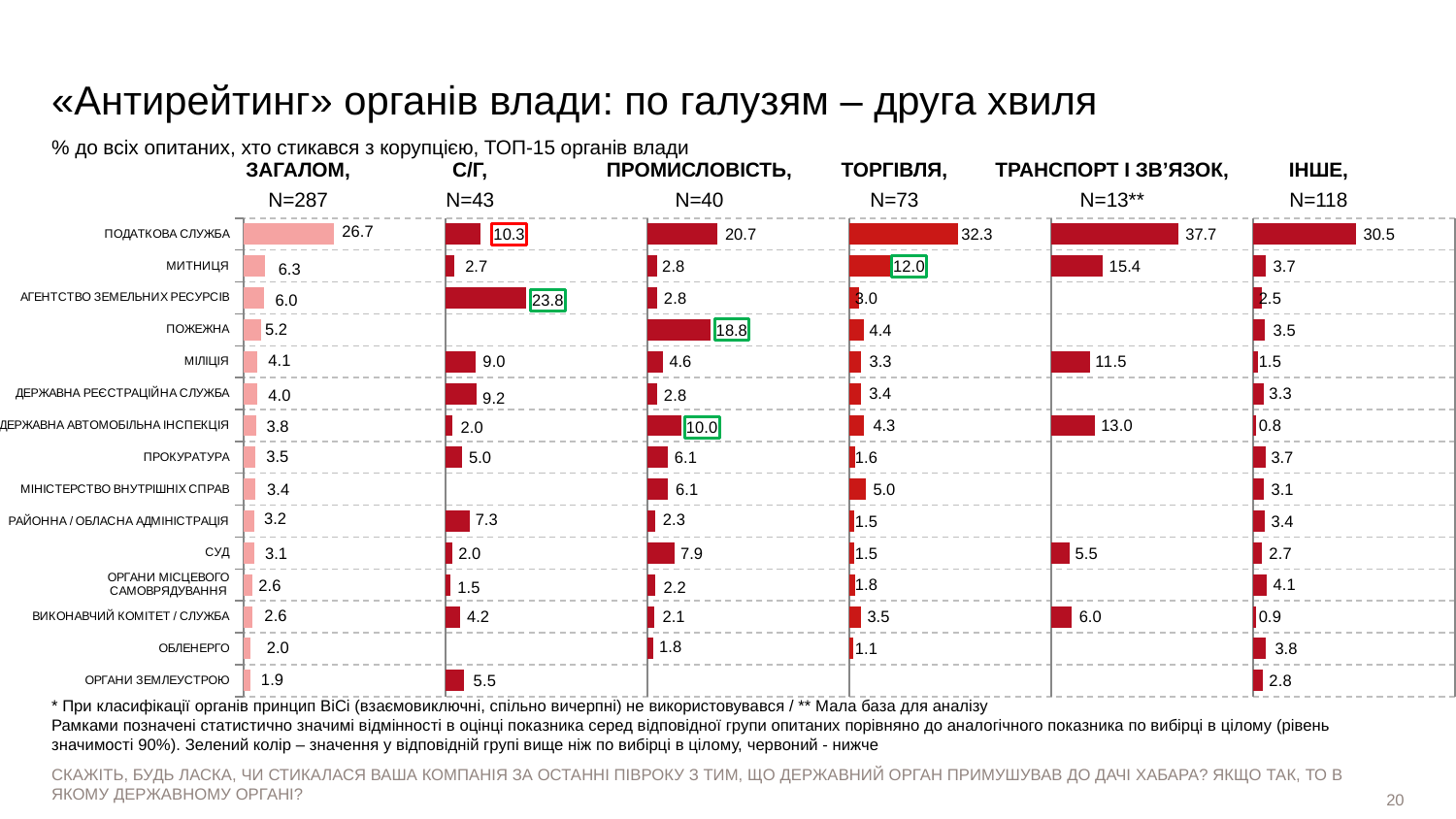
In the ТРАНСПОРТ І ЗВ'ЯЗОК (N=13) chart, what is the difference between ПОДАТКОВА СЛУЖБА and МИТНИЦЯ? 22.3 In the ПРОМИСЛОВІСТЬ (N=40) chart, what is the value for ПОЖЕЖНА? 18.8 In the С/Г (N=43) chart, which organ has the highest value? АГЕНТСТВО ЗЕМЕЛЬНИХ РЕСУРСІВ In the ТРАНСПОРТ І ЗВ'ЯЗОК (N=13) chart, what is the value for ДЕРЖАВНА АВТОМОБІЛЬНА ІНСПЕКЦІЯ? 13.0 In the ІНШЕ (N=118) chart, which organ has the lowest value? ДЕРЖАВНА АВТОМОБІЛЬНА ІНСПЕКЦІЯ In the ЗАГАЛОМ (N=287) chart, what is the value for ПОДАТКОВА СЛУЖБА? 26.7 In the С/Г (N=43) chart, what is the value for АГЕНТСТВО ЗЕМЕЛЬНИХ РЕСУРСІВ? 23.8 In the ТОРГІВЛЯ (N=73) chart, what is the value for МИТНИЦЯ? 12.0 According to the note on the slide, what does a green frame around a value indicate? The value in the group is higher than in the sample as a whole In the ПРОМИСЛОВІСТЬ (N=40) chart, which is larger: СУД or ПРОКУРАТУРА? СУД What kind of chart is used for the ТОРГІВЛЯ (N=73) panel? Bar chart How many organs (categories) are listed in the ЗАГАЛОМ (N=287) chart? 15